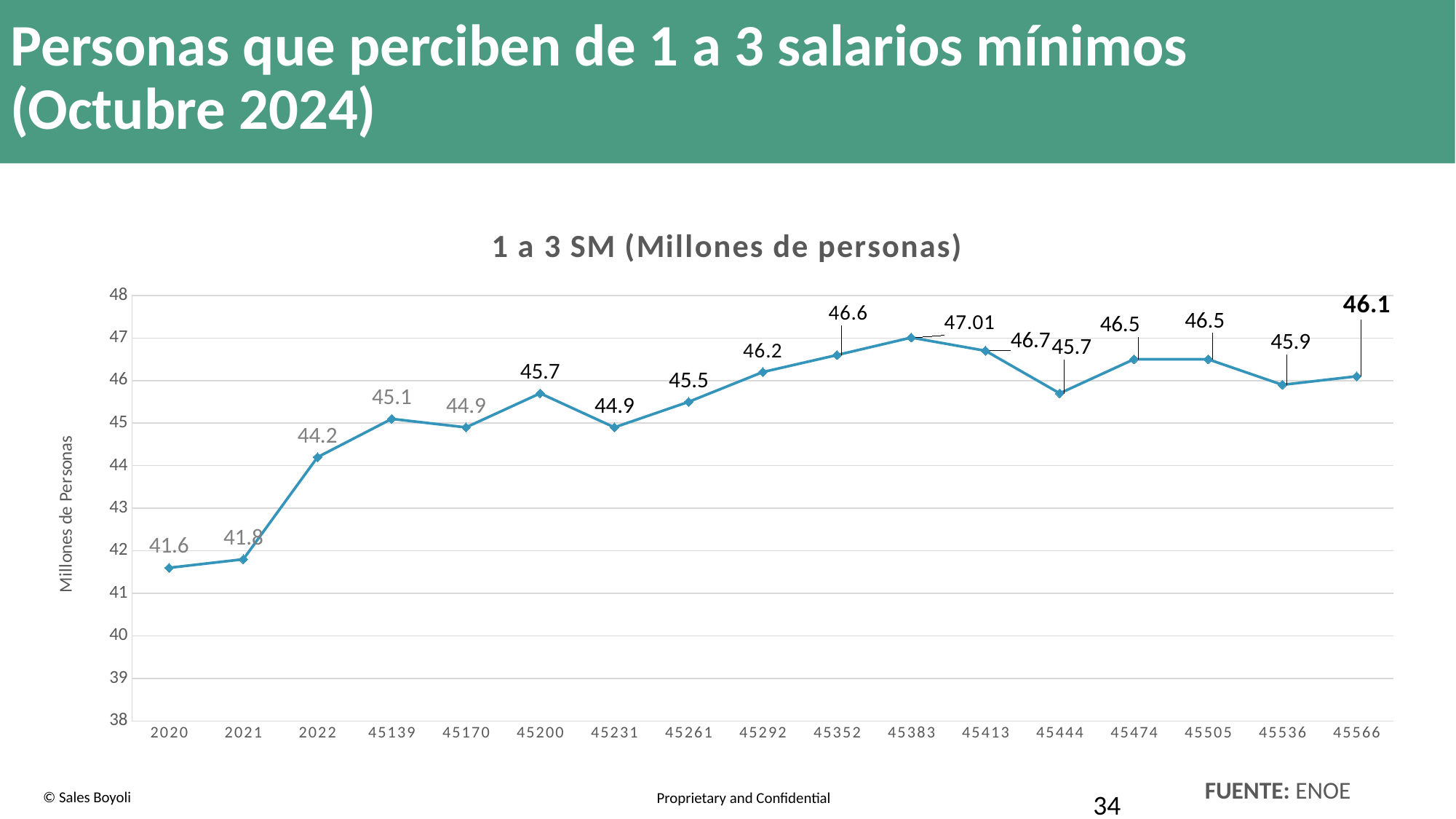
What is the value for 45383? 47.01 What type of chart is shown on the slide? line chart Which category has the highest value? 45383 What is the value for 2022? 44.2 What is the difference between the values for 2022 and 2021? 2.4 How many data points are plotted on the chart? 17 What is the value for 2020? 41.6 What is the value for the last point, 45566? 46.1 What is the title of the chart? 1 a 3 SM (Millones de personas) Which category has the lowest value? 2020 Do the values generally rise or fall from 2020 to 45383? rise Which is larger, the value for 45444 or the value for 45474? 45474